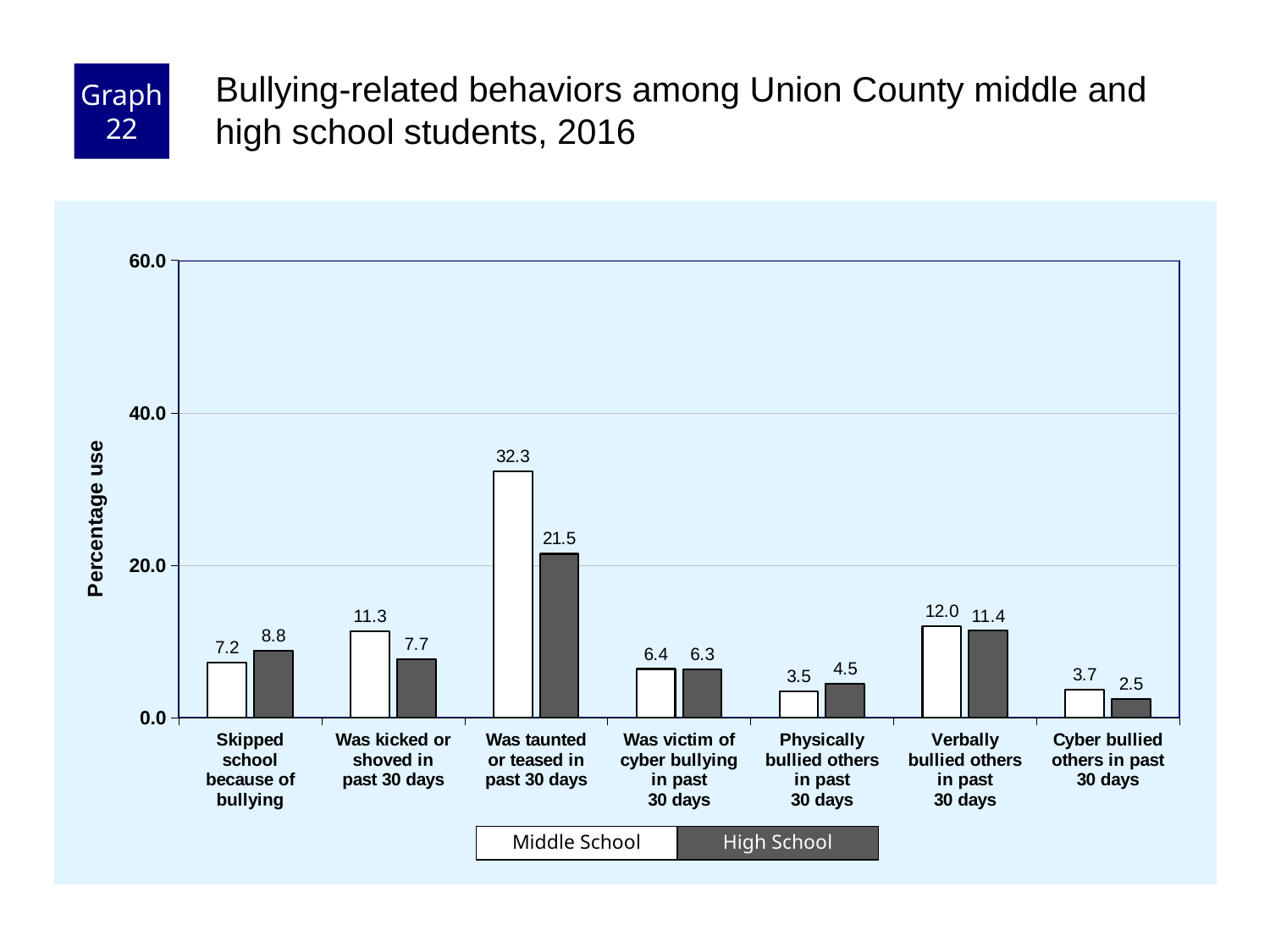
What is the difference between the Middle School and High School values for 'Was taunted or teased in past 30 days'? 10.8 How many series does the legend list? 2 What is the label of the y axis? Percentage use What is the High School value for 'Cyber bullied others in past 30 days'? 2.5 For 'Physically bullied others in past 30 days', which is larger: the Middle School or High School value? High School What is the High School value for 'Skipped school because of bullying'? 8.8 Which category has the lowest High School value? Cyber bullied others in past 30 days Is the Middle School value for 'Was taunted or teased in past 30 days' greater or less than 40.0? less How many categories are shown on the x axis? 7 What is the Middle School value for 'Was taunted or teased in past 30 days'? 32.3 What kind of chart is shown on the slide? bar chart Which category has the highest Middle School value? Was taunted or teased in past 30 days